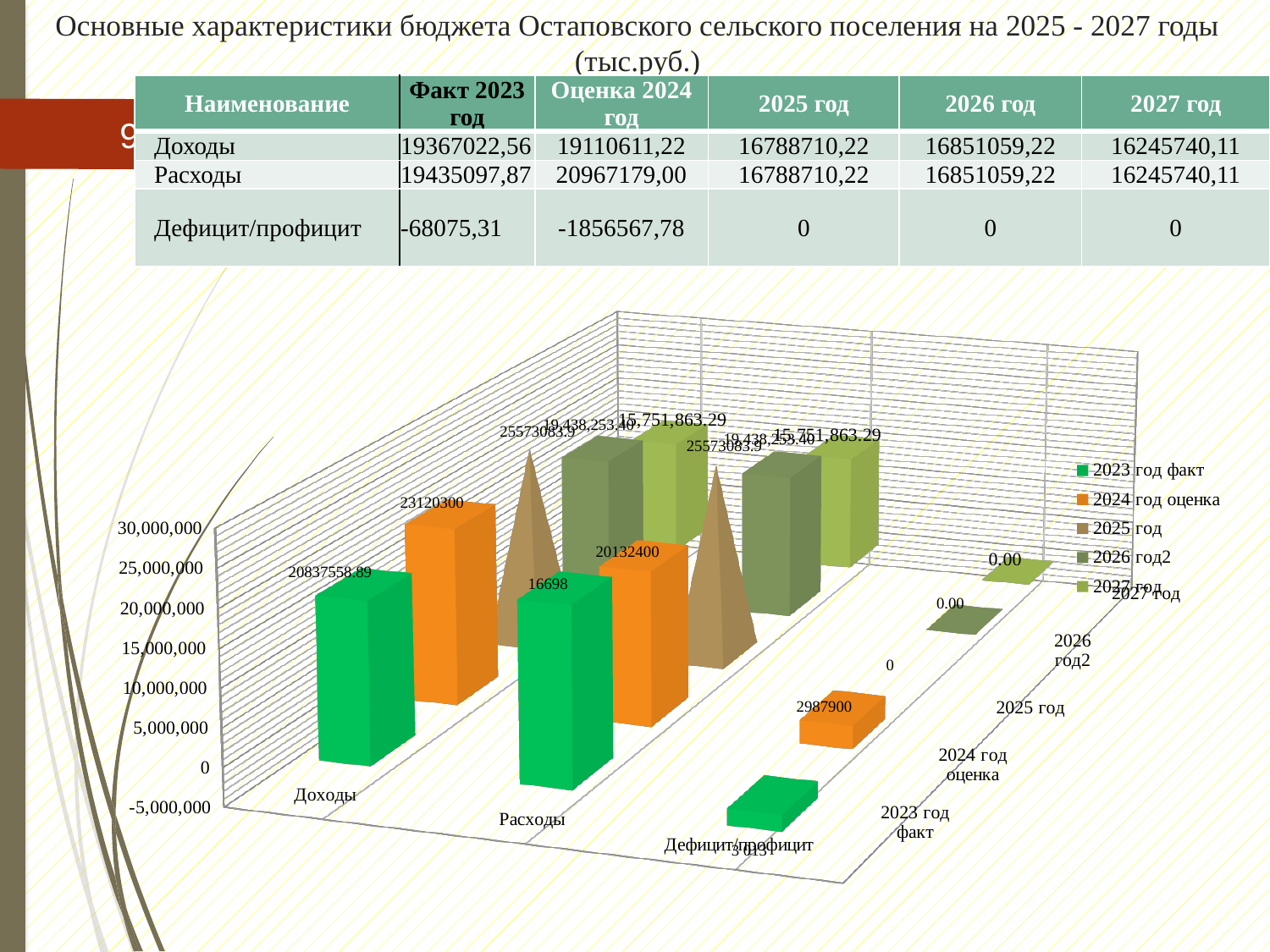
What is the difference between the Доходы values for 2024 год оценка and 2023 год факт? 2282741.11 What colour represents the 2024 год оценка series in the chart? orange Is the value for Расходы in the 2024 год оценка series greater or less than 15,000,000? greater What is the value for Доходы in the 2024 год оценка series? 23120300 How many series does the chart legend list? 5 How many categories are shown along the x axis of the chart? 3 What is the value for Дефицит/профицит in the 2025 год series? 0 Which is larger for Доходы: the 2023 год факт value or the 2024 год оценка value? 2024 год оценка What kind of chart is shown on the slide? bar chart What is the value for Расходы in the 2024 год оценка series? 20132400 What is the value for Доходы in the 2023 год факт series? 20837558.89 What is the value for Дефицит/профицит in the 2024 год оценка series? 2987900